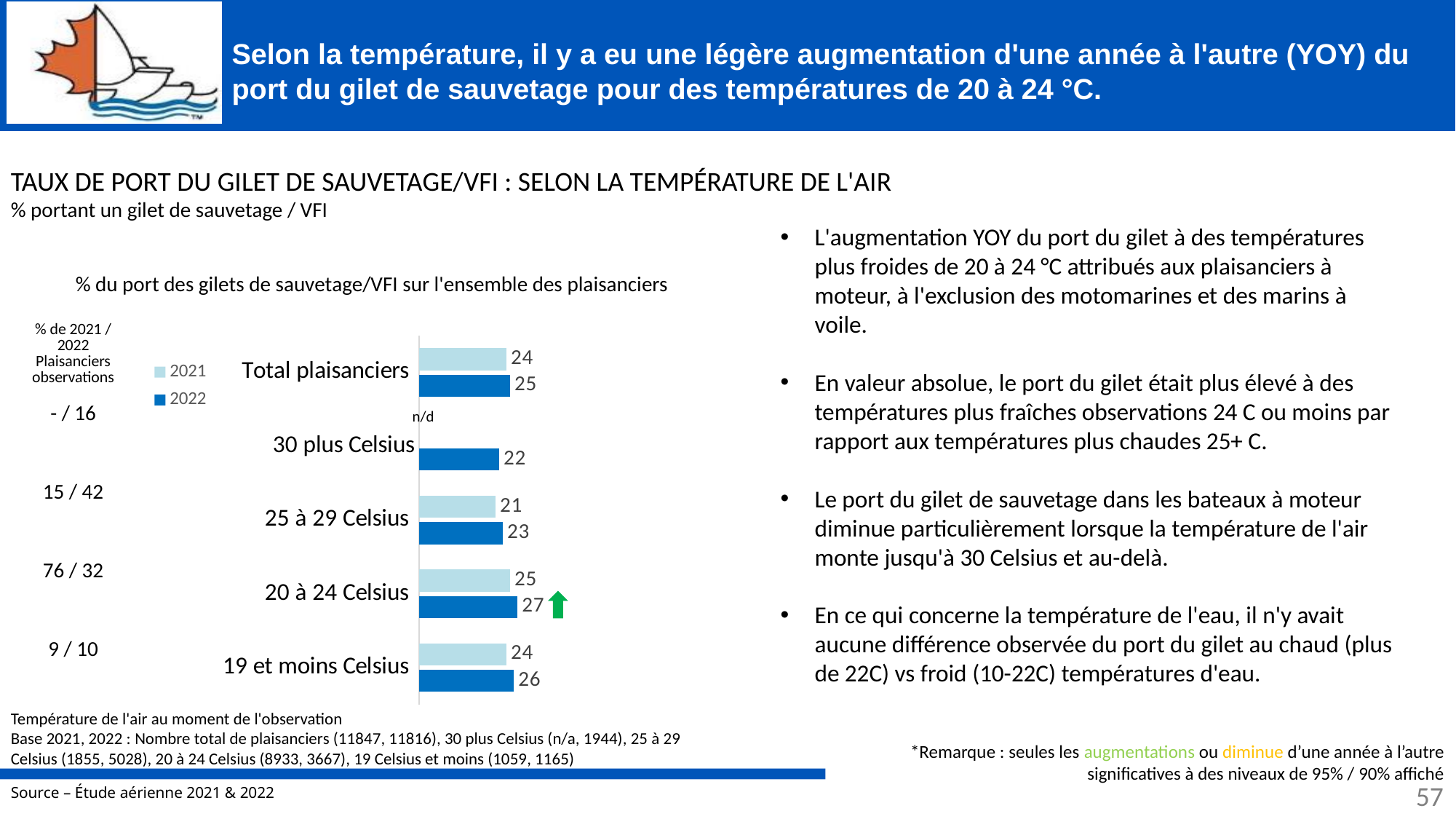
What is the 2021 value for Total plaisanciers? 24 What kind of chart is shown? bar chart Which category has the highest 2022 value? 20 à 24 Celsius Which category shows 'n/d' instead of a 2021 value? 30 plus Celsius Which is larger for 25 à 29 Celsius: the 2021 value or the 2022 value? 2022 What is the 2022 value for 30 plus Celsius? 22 What is the difference between the 2022 and 2021 values for 19 et moins Celsius? 2 What is the 2022 value for 20 à 24 Celsius? 27 Which category has the lowest 2022 value? 30 plus Celsius What is the 2021 value for 25 à 29 Celsius? 21 How many categories are shown on the chart? 5 How many series does the legend list? 2